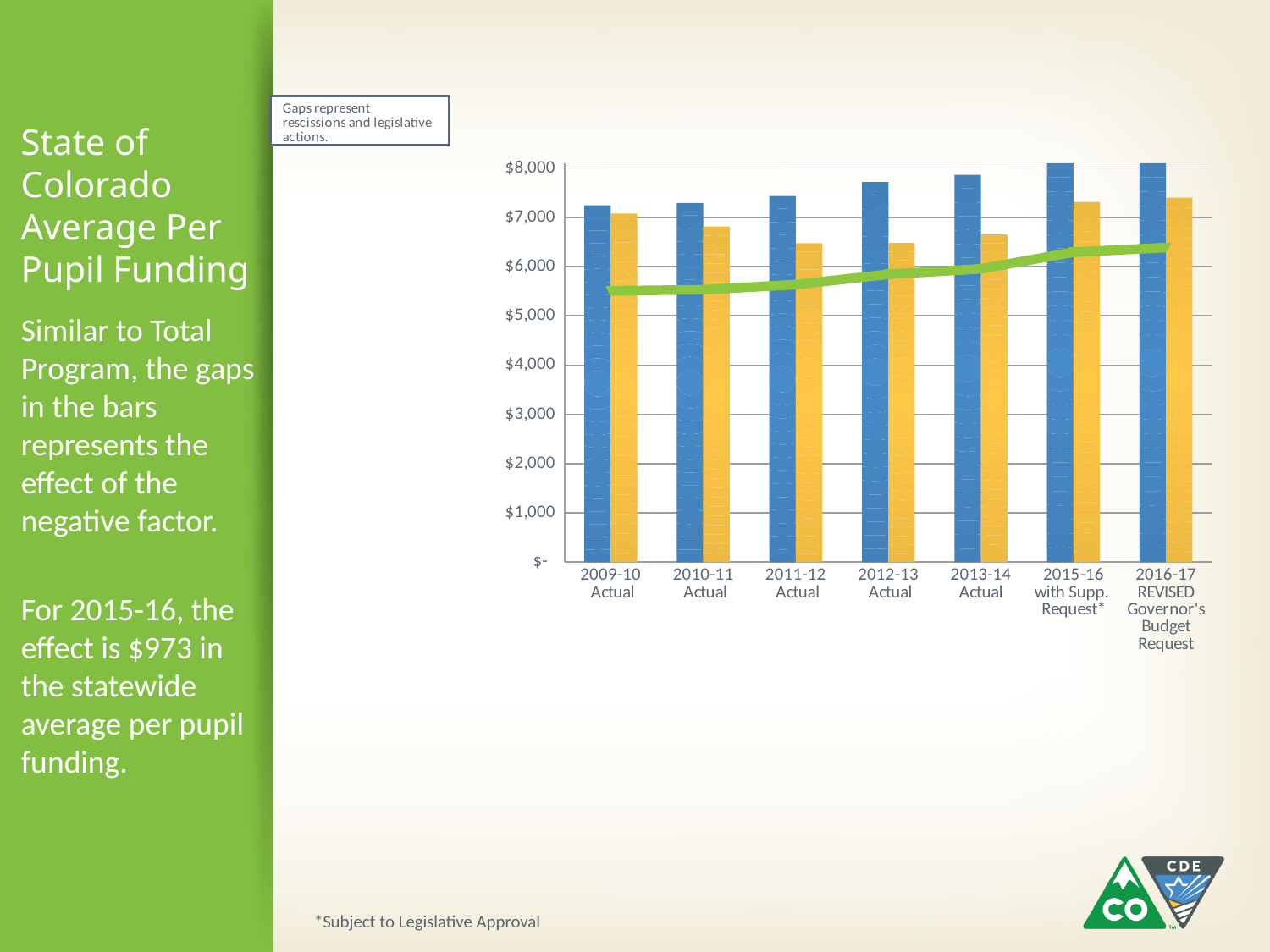
Is the value of the blue bar for 2013-14 Actual greater or less than $8,000? less How many fiscal-year categories are shown on the x axis of the chart? 7 Is the value of the yellow bar for 2011-12 Actual greater or less than $6,000? greater Is the value of the green line at 2009-10 Actual greater or less than $6,000? less What is the highest value labelled on the chart's vertical axis? $8,000 For 2015-16 with Supp. Request*, which bar is taller, the blue bar or the yellow bar? The blue bar Does the green line rise or fall from 2009-10 Actual to 2016-17 REVISED Governor's Budget Request? Rises What kind of chart is shown on the slide? Bar chart with a line overlay